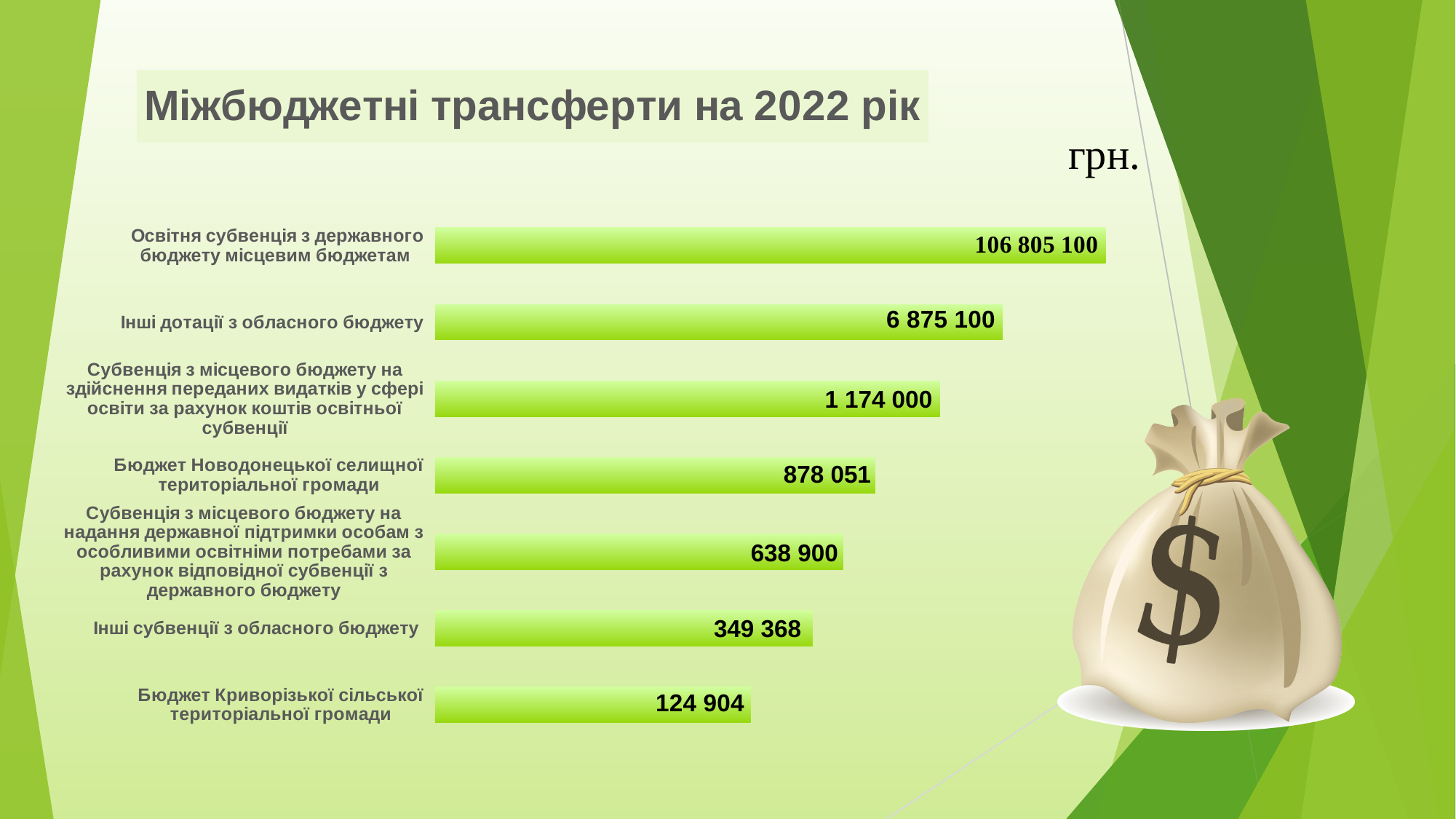
Which is larger: the value for "Інші дотації з обласного бюджету" or the value for "Субвенція з місцевого бюджету на здійснення переданих видатків у сфері освіти за рахунок коштів освітньої субвенції"? Інші дотації з обласного бюджету What kind of chart is shown on the slide? Bar chart What is the difference between the value for "Інші субвенції з обласного бюджету" and the value for "Бюджет Криворізької сільської територіальної громади"? 224 464 What is the value for "Бюджет Новодонецької селищної територіальної громади"? 878 051 How many categories are shown in the chart? 7 What is the value for "Бюджет Криворізької сільської територіальної громади"? 124 904 What is the difference between the value for "Бюджет Новодонецької селищної територіальної громади" and the value for "Субвенція з місцевого бюджету на надання державної підтримки особам з особливими освітніми потребами за рахунок відповідної субвенції з державного бюджету"? 239 151 Which category has the lowest value? Бюджет Криворізької сільської територіальної громади Which category has the highest value? Освітня субвенція з державного бюджету місцевим бюджетам What is the value for "Інші субвенції з обласного бюджету"? 349 368 What is the value for "Інші дотації з обласного бюджету"? 6 875 100 What is the value for "Освітня субвенція з державного бюджету місцевим бюджетам"? 106 805 100